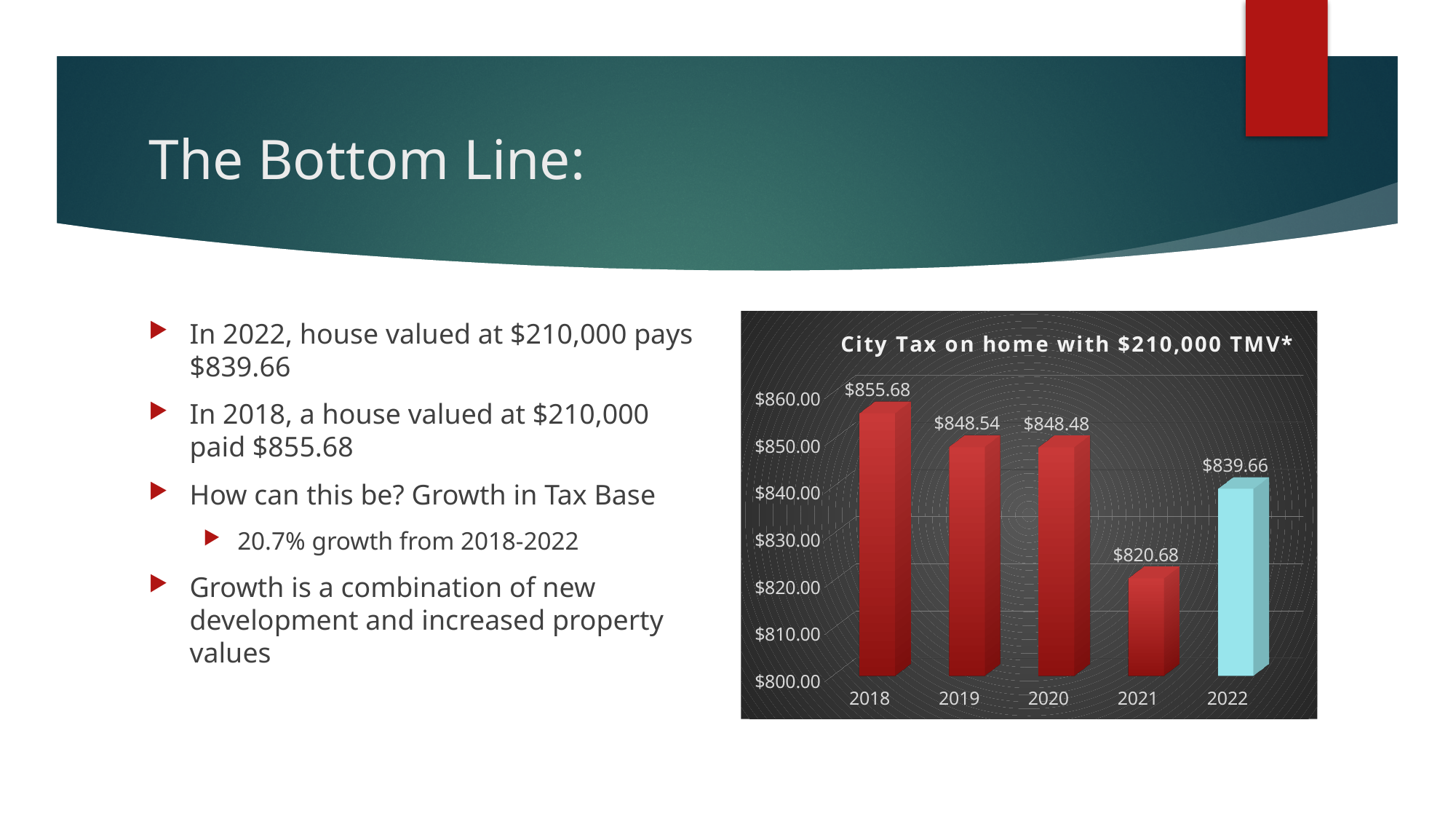
What is the city tax value shown for 2018? $855.68 What is the city tax value shown for 2022? $839.66 What is the city tax value shown for 2021? $820.68 How many years are shown on the x axis of the chart? 5 Which year has the highest city tax value? 2018 Which is larger, the value for 2019 or the value for 2021? 2019 Is the value for 2021 greater or less than $830.00? less What is the difference between the 2018 value and the 2022 value? $16.02 What is the title of the chart? City Tax on home with $210,000 TMV* What type of chart is shown on the slide? Bar chart Which year has the lowest city tax value? 2021 What is the difference between the 2022 value and the 2021 value? $18.98